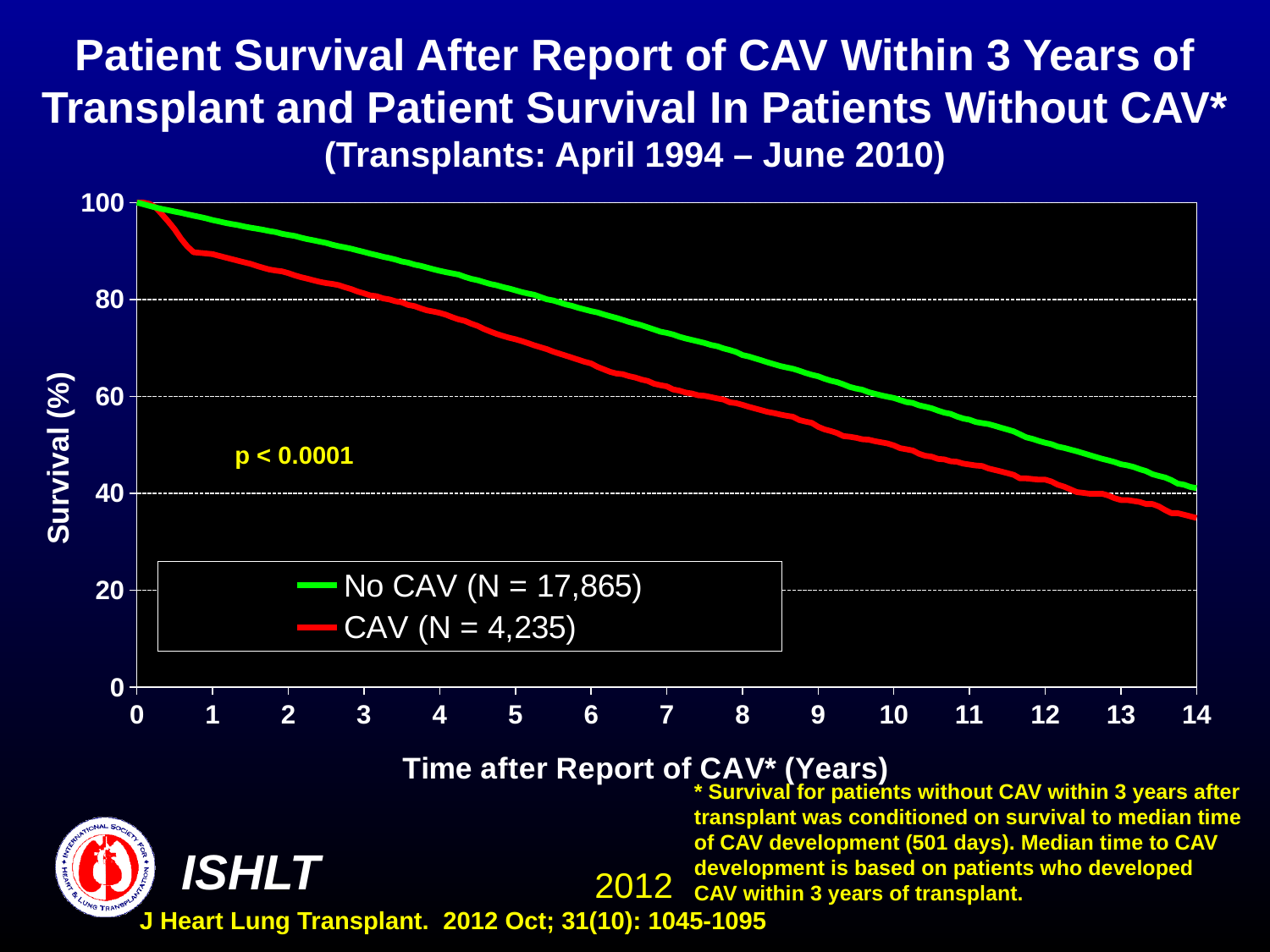
Is the survival for the No CAV group at 5 years greater or less than 80%? greater Do the survival curves rise or fall as time after report of CAV increases? Fall Is the survival for the CAV group at 10 years greater or less than 60%? less Is the survival for the CAV group at 14 years greater or less than 40%? less Which group has the lower survival at 14 years? CAV What kind of chart is shown on the slide? Line chart How many series does the legend list? 2 What is the survival value for both groups at year 0? 100 Which group has the higher survival at 7 years after report of CAV? No CAV What is the N for the CAV group shown in the legend? 4,235 What is the N for the No CAV group shown in the legend? 17,865